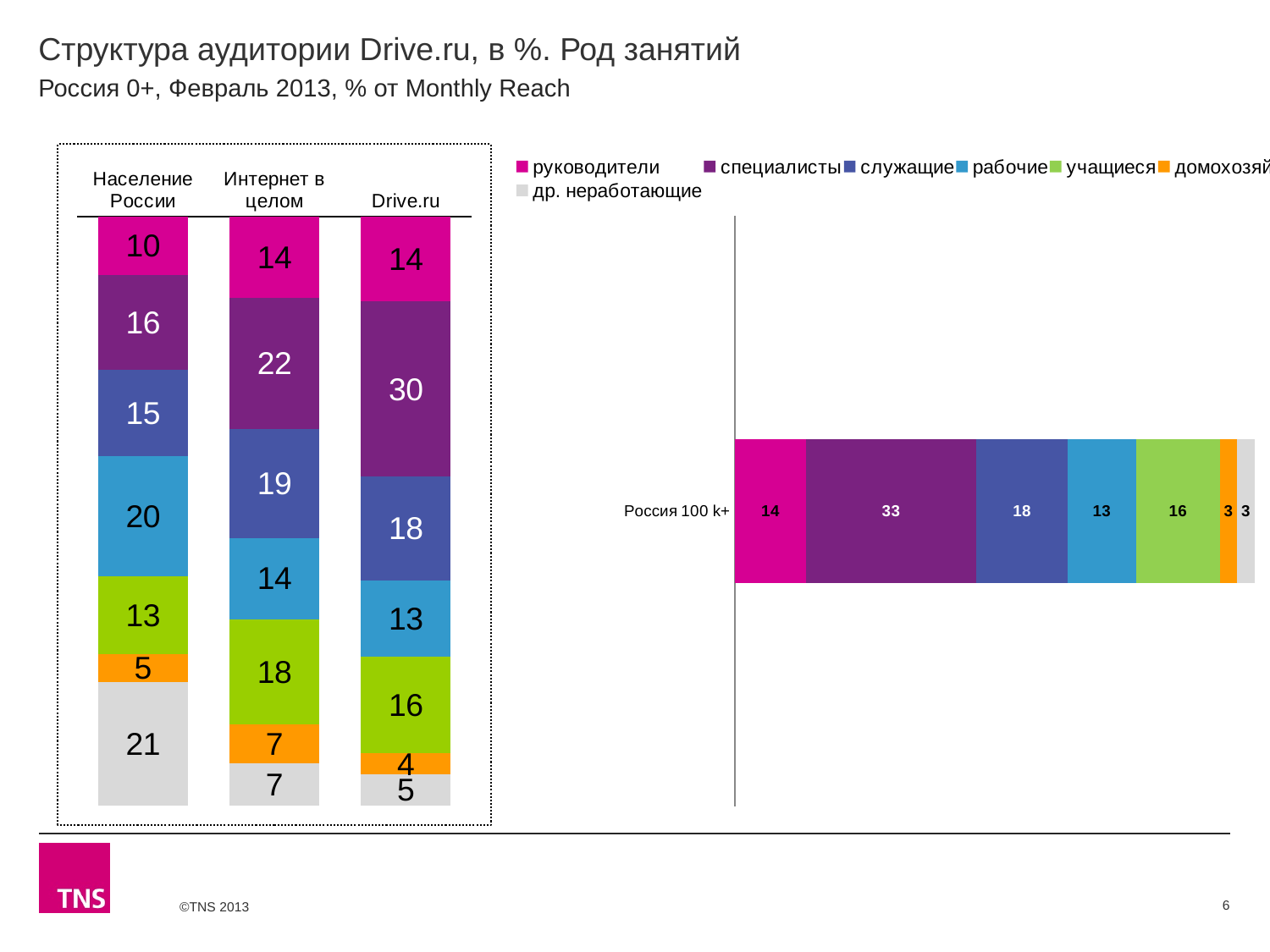
In the left chart, what is the value of the специалисты segment for Drive.ru? 30 How many bars (categories) are shown in the left chart? 3 In the left chart, what is the difference between the специалисты values for Drive.ru and Население России? 20 In the right chart, what is the value of the специалисты segment for Россия 100 k+? 33 In the left chart, which segment is the smallest in the Drive.ru bar? домохозяйки What kind of chart is the right chart? stacked bar chart In the left chart, which is larger: the рабочие value for Население России or for Drive.ru? Население России In the right chart, what is the total of the Россия 100 k+ bar? 100 How many series does the legend list? 7 In the left chart, which segment is the largest in the Drive.ru bar? специалисты In the left chart, what is the value of the учащиеся segment for Интернет в целом? 18 In the left chart, what is the value of the др. неработающие segment for Население России? 21